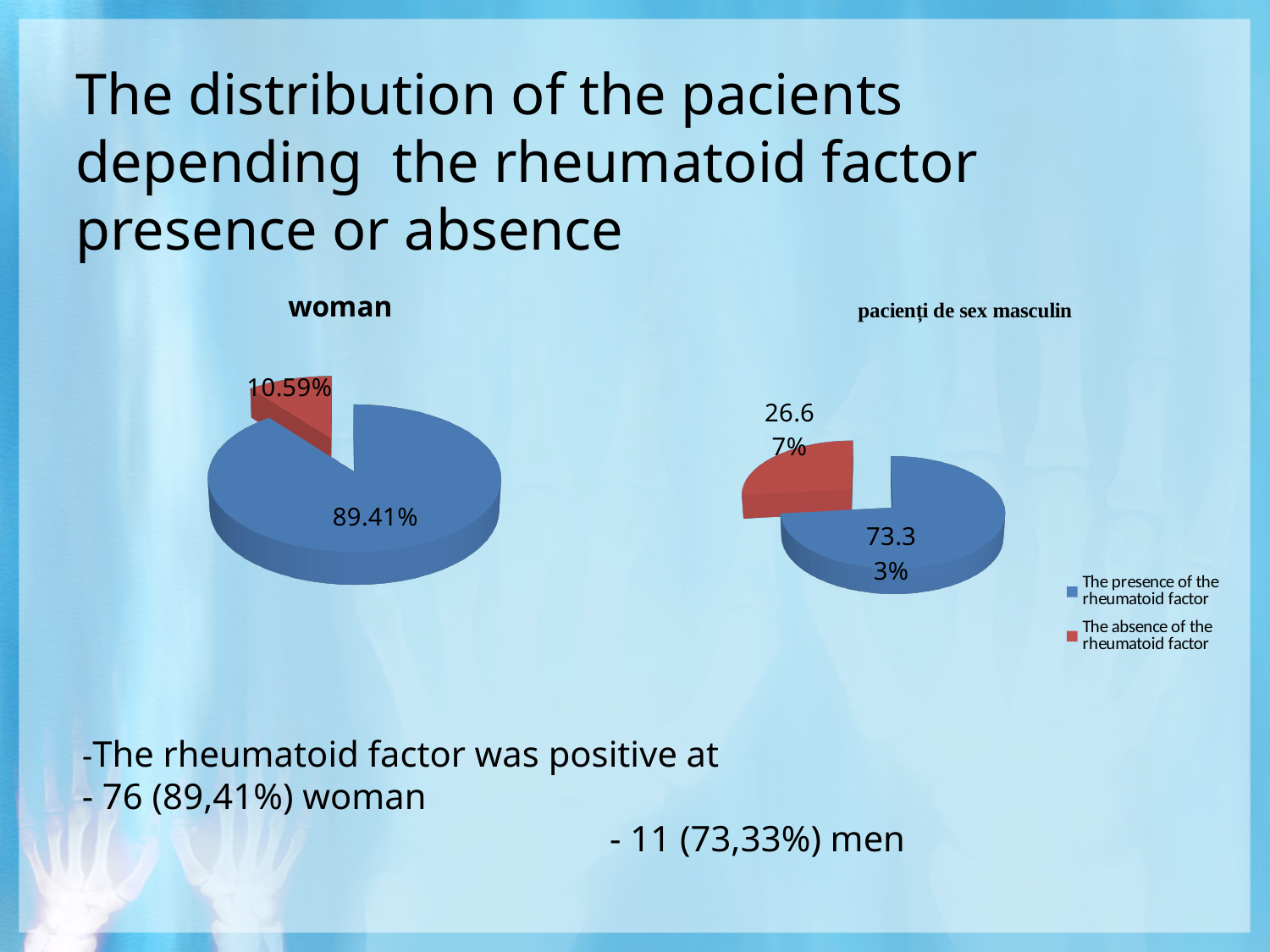
In the "pacienți de sex masculin" pie chart, what share of patients had the absence of the rheumatoid factor? 26.67% In the "woman" pie chart, what share of patients had the absence of the rheumatoid factor? 10.59% In the "pacienți de sex masculin" pie chart, what share of patients had the presence of the rheumatoid factor? 73.33% How many entries does the legend on the slide list? 2 In the pie charts, what colour represents the absence of the rheumatoid factor? Red Is the share of patients with the presence of the rheumatoid factor larger in the "woman" chart or in the "pacienți de sex masculin" chart? woman In the "woman" pie chart, what share of patients had the presence of the rheumatoid factor? 89.41% In the "woman" pie chart, what is the difference between the presence and absence shares? 78.82% What type of chart is the "woman" chart? Pie chart In the "woman" pie chart, which slice is the largest? The presence of the rheumatoid factor How many slices does the "pacienți de sex masculin" pie chart have? 2 In the "pacienți de sex masculin" pie chart, which slice is the smallest? The absence of the rheumatoid factor